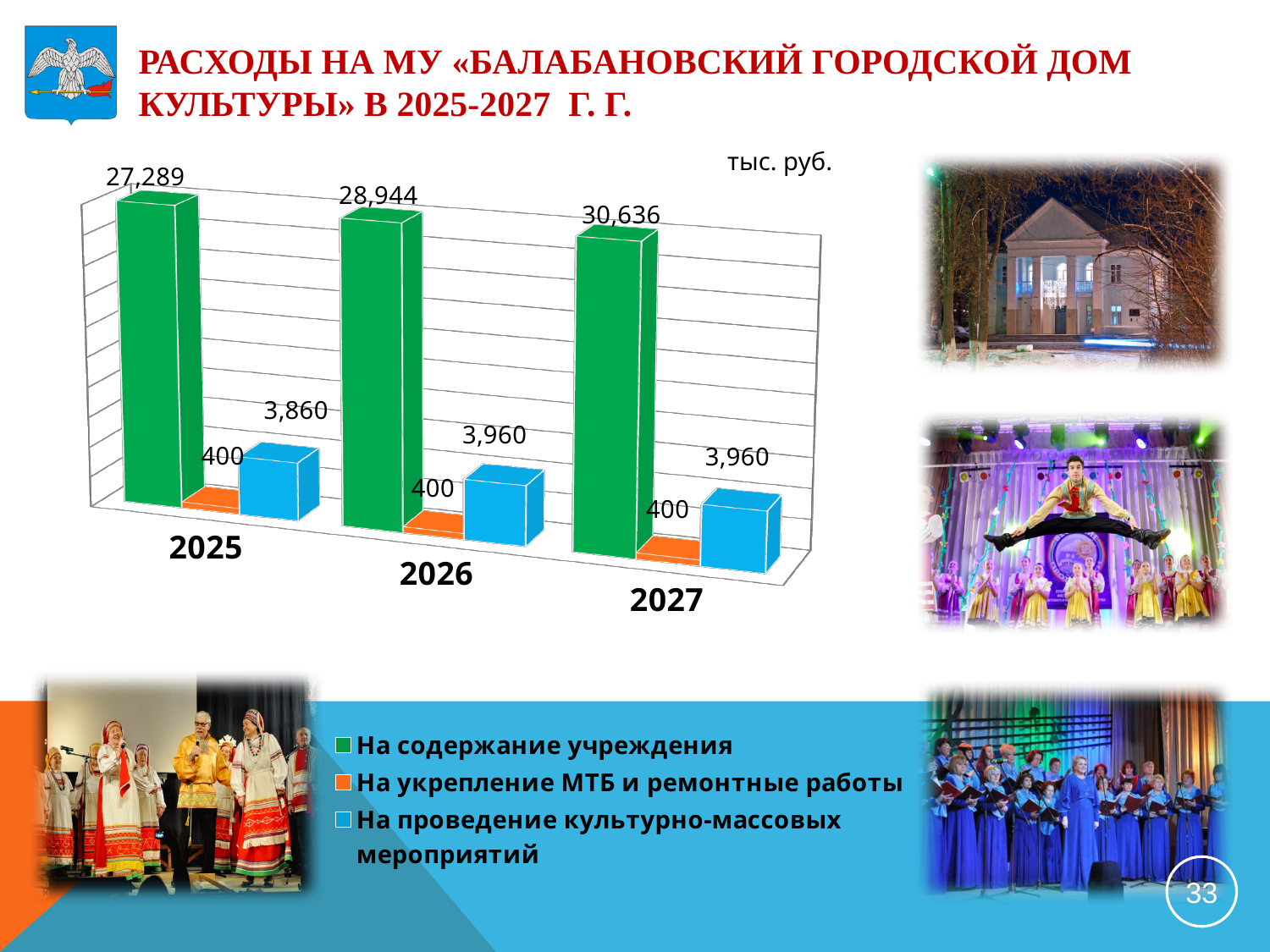
How many years are shown on the x axis of the chart? 3 What is the value for «На содержание учреждения» in 2025? 27,289 What is the difference between the «На проведение культурно-массовых мероприятий» values for 2026 and 2025? 100 In which year is the value for «На содержание учреждения» the highest? 2027 What is the difference between the «На содержание учреждения» values for 2027 and 2026? 1,692 In which year is the value for «На проведение культурно-массовых мероприятий» the lowest? 2025 Does the value for «На содержание учреждения» rise or fall from 2025 to 2027? Rises Which is larger: «На содержание учреждения» in 2025 or in 2026? 2026 What is the value for «На проведение культурно-массовых мероприятий» in 2026? 3,960 What is the value for «На укрепление МТБ и ремонтные работы» in 2027? 400 What kind of chart is shown on the slide? Bar chart How many series does the legend list? 3